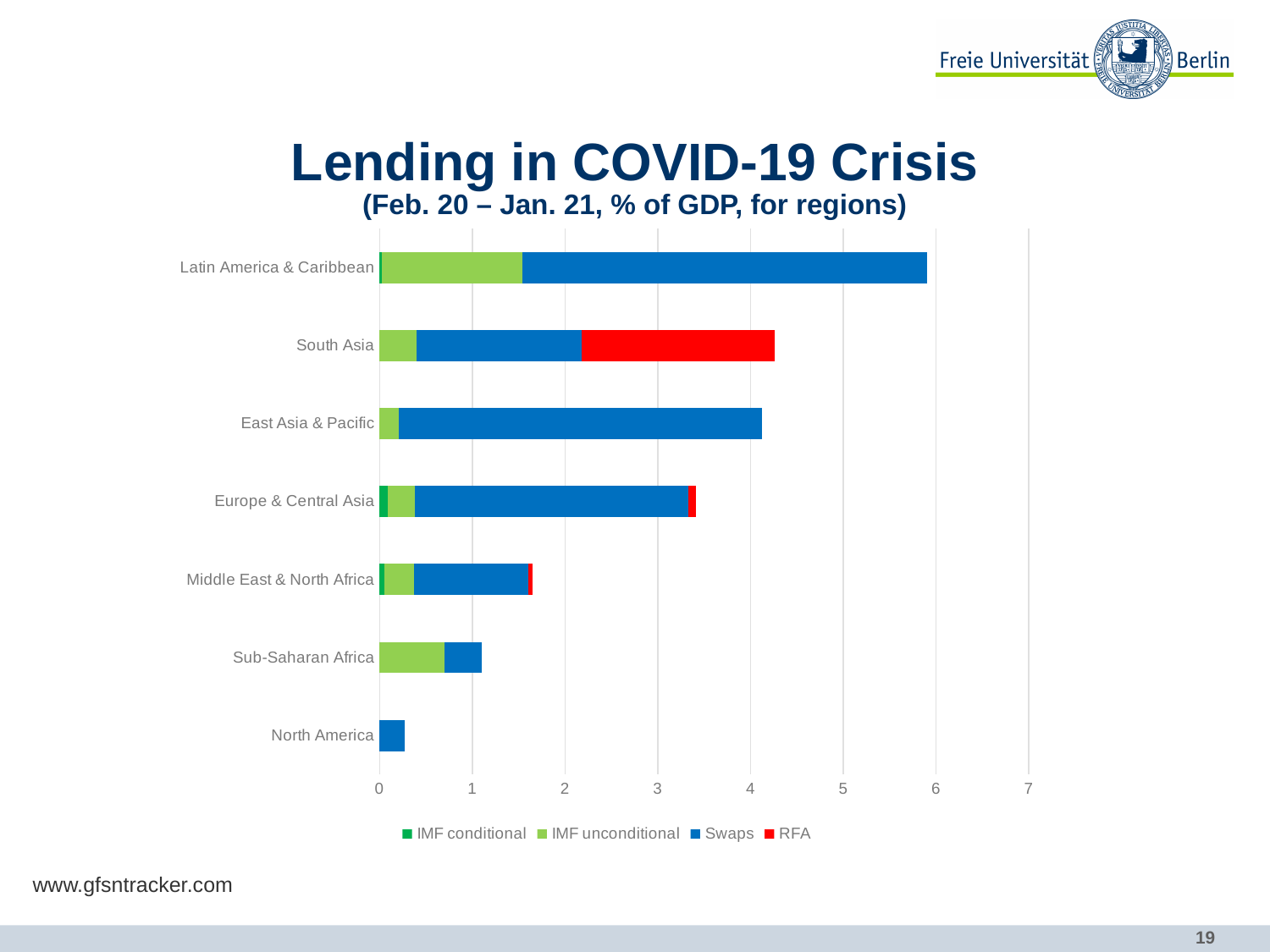
Which region has the largest RFA segment? South Asia Is the total value for Latin America & Caribbean greater or less than 5? greater Which region has the highest total lending as a share of GDP? Latin America & Caribbean Is the total value for North America greater or less than 1? less Which region has the lowest total lending as a share of GDP? North America Is the total value for Europe & Central Asia greater or less than 3? greater How many regions are shown on the chart? 7 How many series does the legend list? 4 What is the title of the chart? Lending in COVID-19 Crisis Which has a larger total value, Latin America & Caribbean or South Asia? Latin America & Caribbean What kind of chart is shown on the slide? Stacked bar chart